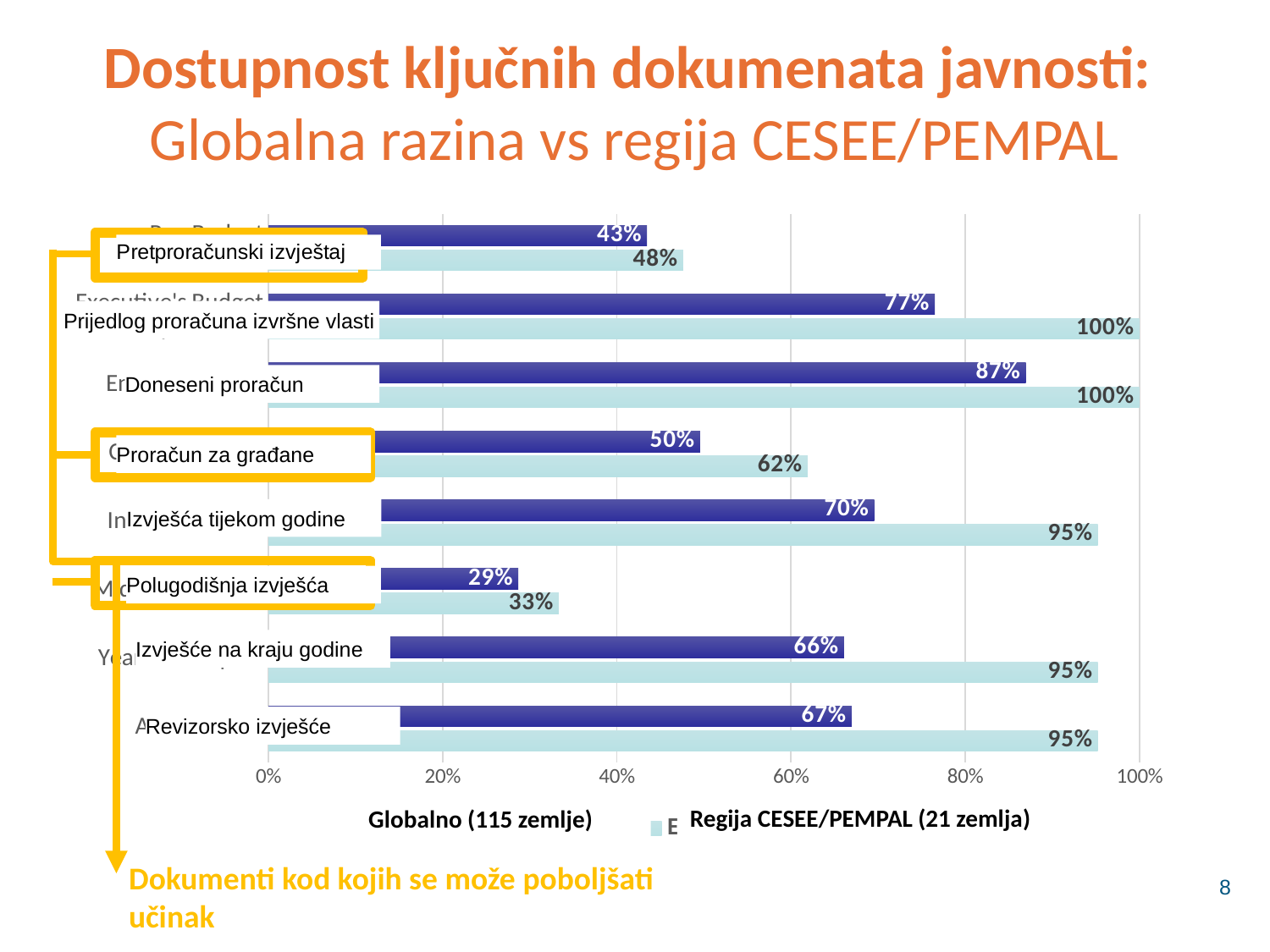
Which is larger for Revizorsko izvješće: the Globalno (115 zemlje) value or the Regija CESEE/PEMPAL (21 zemlja) value? Regija CESEE/PEMPAL (21 zemlja) Which category has the lowest Globalno (115 zemlje) value? Polugodišnja izvješća How many series does the legend list? 2 What is the difference between the Regija CESEE/PEMPAL and Globalno values for Izvješća tijekom godine? 25% What is the Regija CESEE/PEMPAL (21 zemlja) value for Prijedlog proračuna izvršne vlasti? 100% What is the Regija CESEE/PEMPAL (21 zemlja) value for Proračun za građane? 62% What is the Globalno (115 zemlje) value for Doneseni proračun? 87% Which category has the highest Globalno (115 zemlje) value? Doneseni proračun What is the Globalno (115 zemlje) value for Pretproračunski izvještaj? 43% What kind of chart is shown on the slide? Bar chart How many document categories are shown in the chart? 8 What is the Regija CESEE/PEMPAL (21 zemlja) value for Polugodišnja izvješća? 33%